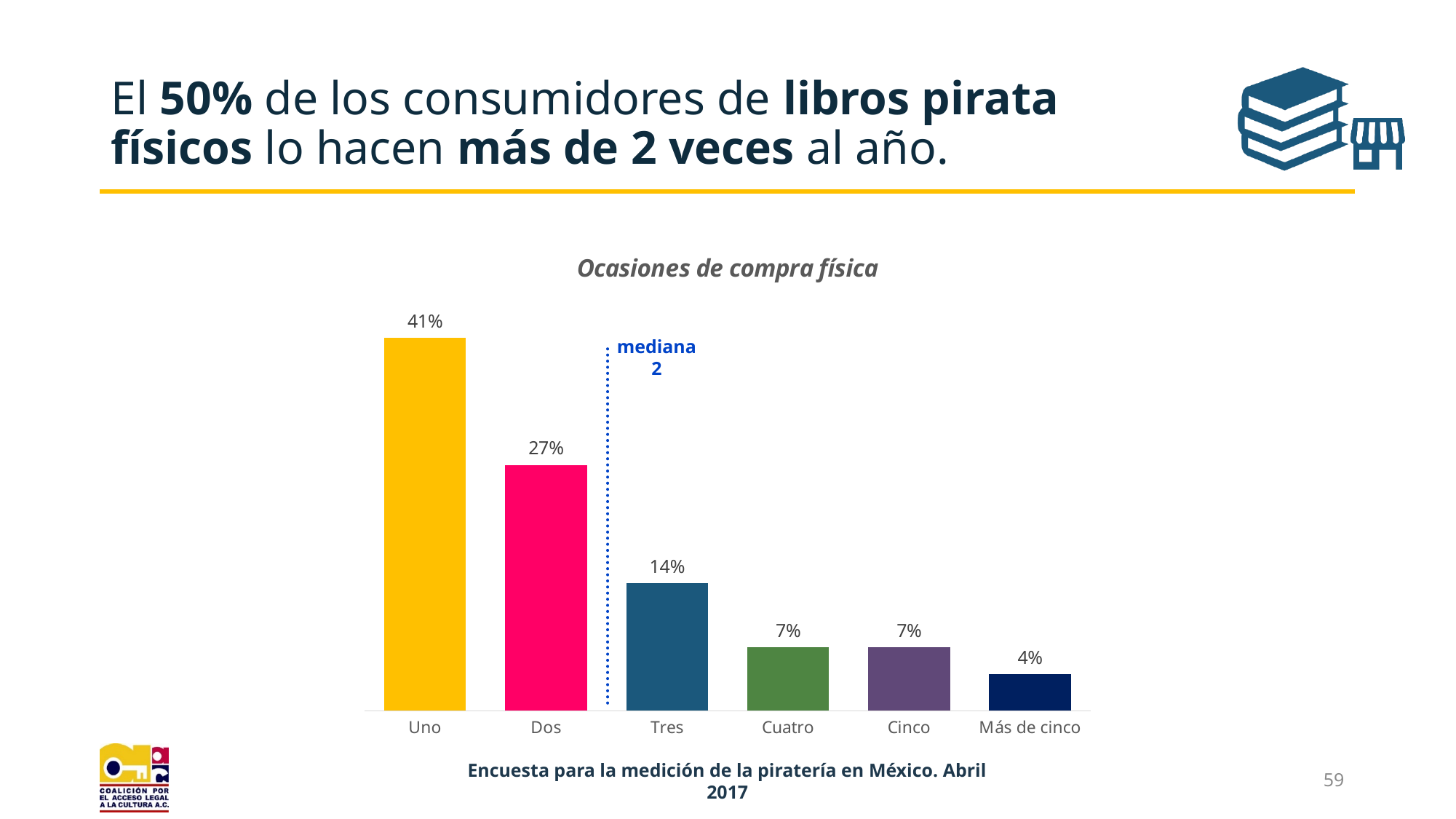
Which category has the lowest value in the chart? Más de cinco What is the value for "Tres" in the chart? 14% What kind of chart is shown on the slide? Bar chart Do the values rise or fall from "Uno" to "Más de cinco" along the x axis? Fall What is the value for "Más de cinco" in the chart? 4% Which is larger, the value for "Dos" or the value for "Tres"? Dos What value is indicated by the dotted "mediana" line in the chart? 2 Which category has the highest value in the chart? Uno What is the difference between the values for "Uno" and "Dos"? 14% What is the value for "Uno" in the chart? 41% How many categories are shown on the x axis of the chart? 6 What is the title of the chart? Ocasiones de compra física